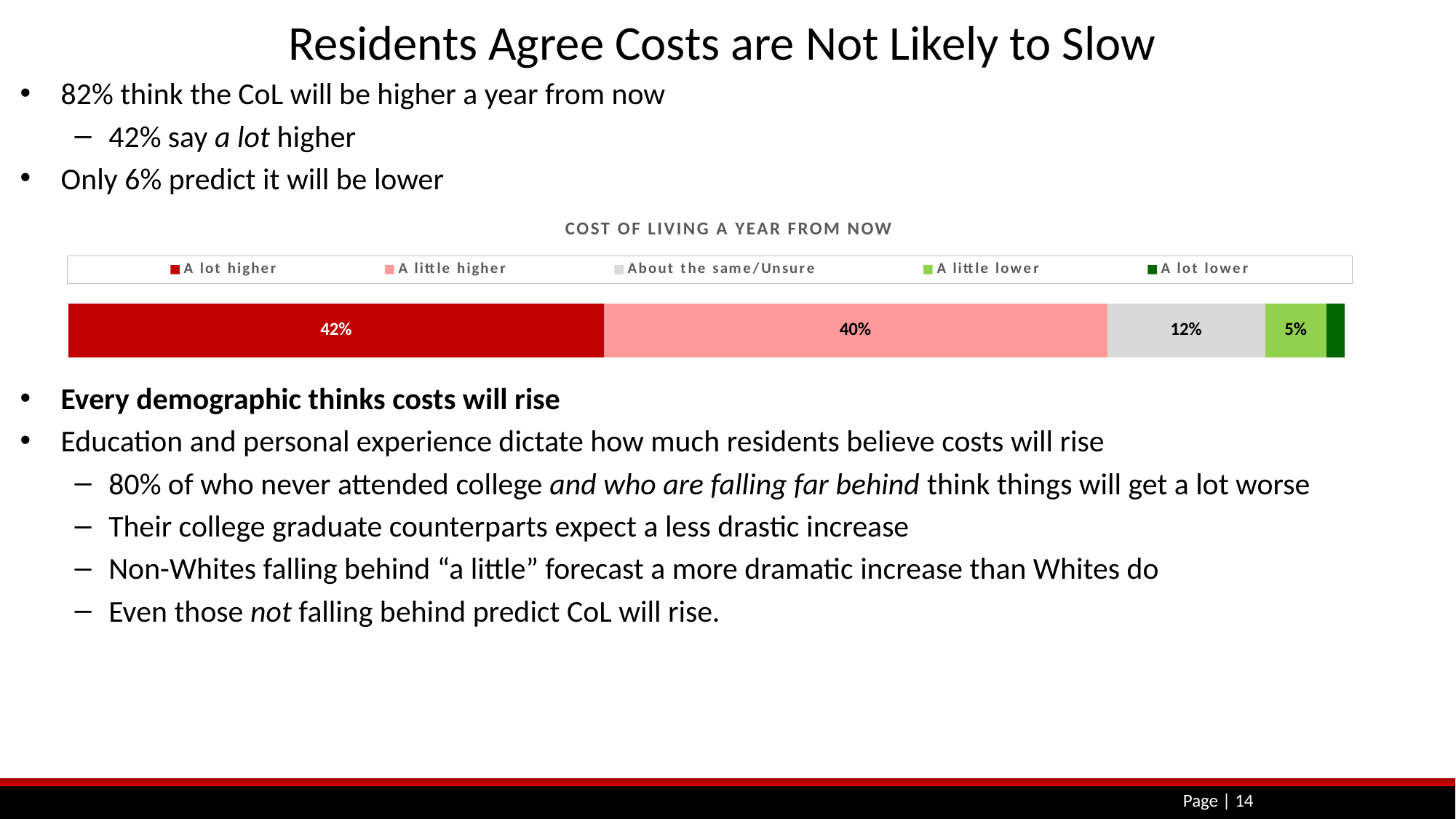
What kind of chart is shown under the heading "COST OF LIVING A YEAR FROM NOW"? Stacked bar chart What is the title of the chart on the slide? COST OF LIVING A YEAR FROM NOW Which is larger in the chart, "A lot higher" or "A little higher"? A lot higher What is the value for "A little lower" in the chart? 5% Which response category has the smallest share in the chart? A lot lower What is the value for "A lot higher" in the chart? 42% What is the value for "A little higher" in the chart? 40% What is the difference between the "About the same/Unsure" and "A little lower" values in the chart? 7 percentage points What is the value for "About the same/Unsure" in the chart? 12% How many series does the chart legend list? 5 What is the difference between the "A lot higher" and "A little higher" values in the chart? 2 percentage points Which response category has the largest share in the chart? A lot higher